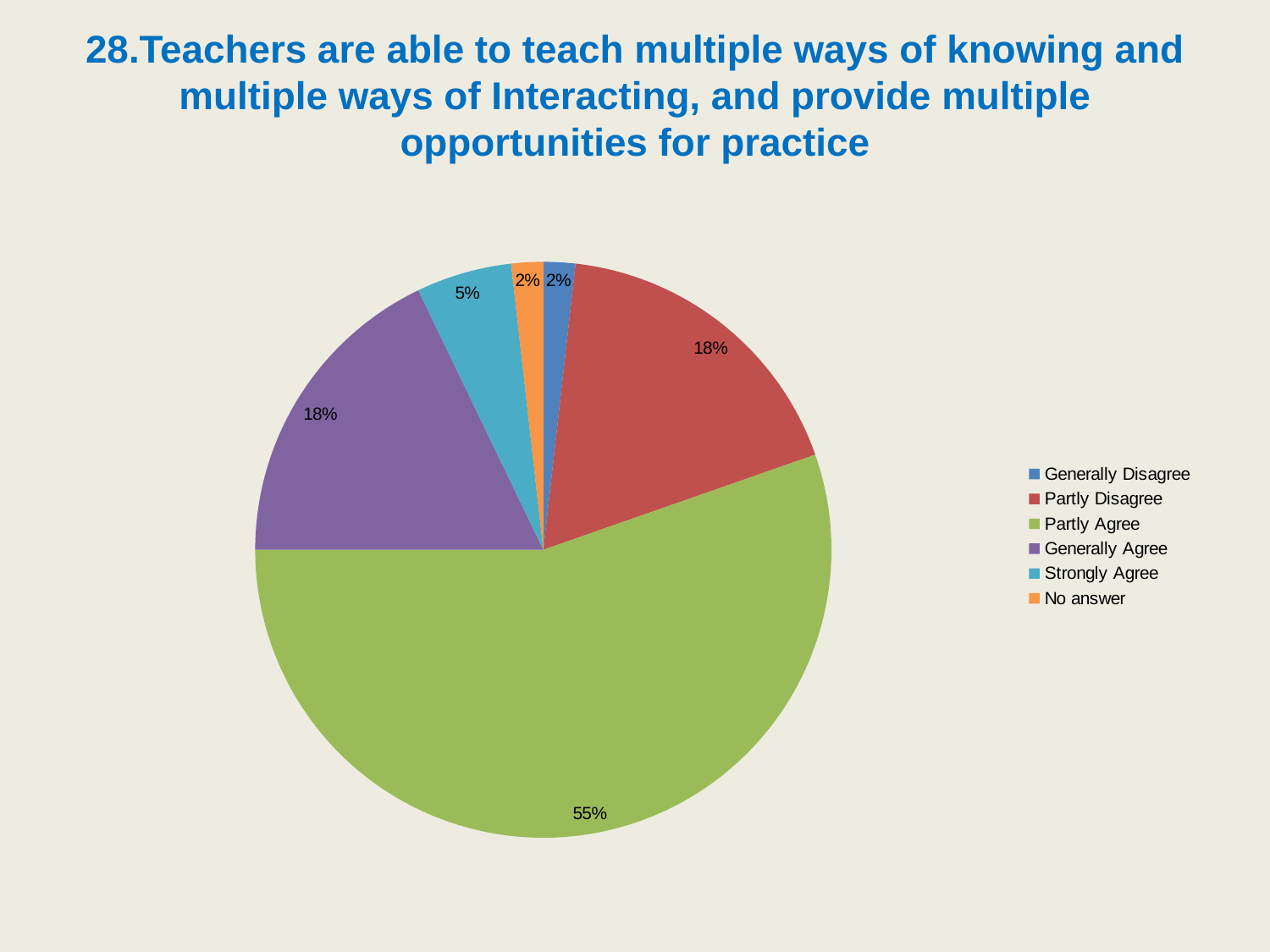
Which category has the largest slice of the pie? Partly Agree What kind of chart is shown on the slide? pie chart What share of the pie is Partly Agree? 55% What is the value for Generally Disagree? 2% What is the difference between the Partly Agree and Generally Agree values? 37% What is the value for Generally Agree? 18% What is the value for No answer? 2% What is the value for Partly Disagree? 18% What colour is the Partly Agree slice? green Which is larger, the value for Strongly Agree or the value for Partly Disagree? Partly Disagree How many categories does the legend list? 6 What is the value for Strongly Agree? 5%